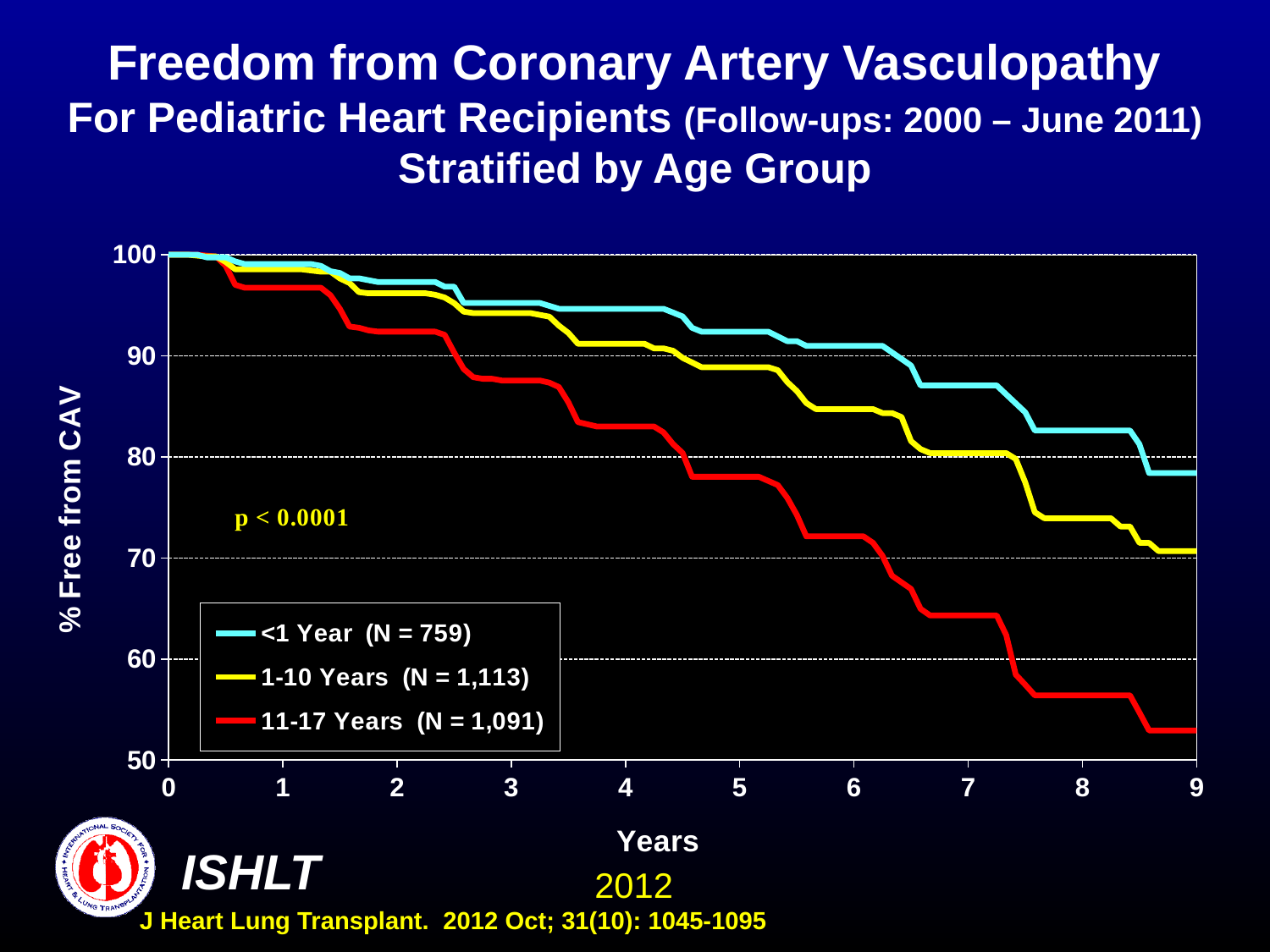
Is the value for the 1-10 Years group at 3 years greater or less than 90? greater Which age group has the highest % free from CAV at 9 years? <1 Year How many series does the legend list? 3 What kind of chart is shown on the slide? line chart Is the value for the <1 Year group at 9 years greater or less than 80? less Which age group has the lowest % free from CAV at 9 years? 11-17 Years Is the value for the <1 Year group at 9 years greater or less than 70? greater What p-value is printed on the chart? p < 0.0001 Do the values for the 11-17 Years group rise or fall as years increase? fall At 7 years, which is larger: the value for the <1 Year group or the 11-17 Years group? <1 Year